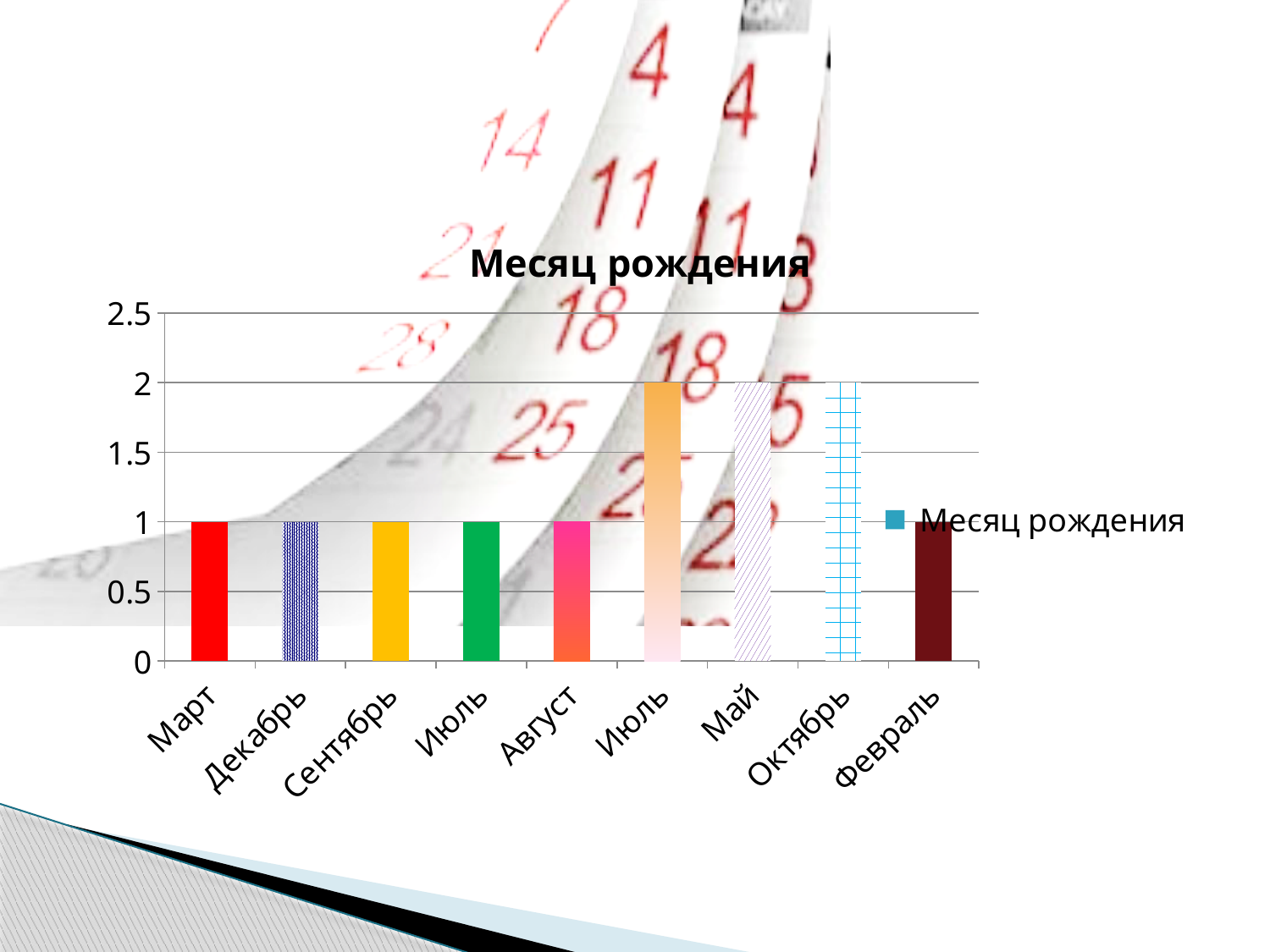
How many categories are shown on the x axis of the chart? 9 How many categories have a value of 2? 3 What is the value for Февраль? 1 Which is larger, the value for Октябрь or the value for Сентябрь? Октябрь What is the value for Май? 2 What is the difference between the values for Май and Март? 1 What kind of chart is shown on the slide? bar chart What is the title of the chart? Месяц рождения How many series does the legend list? 1 Is the value for Август greater or less than 1.5? less What is the value for Октябрь? 2 What is the value for Март? 1